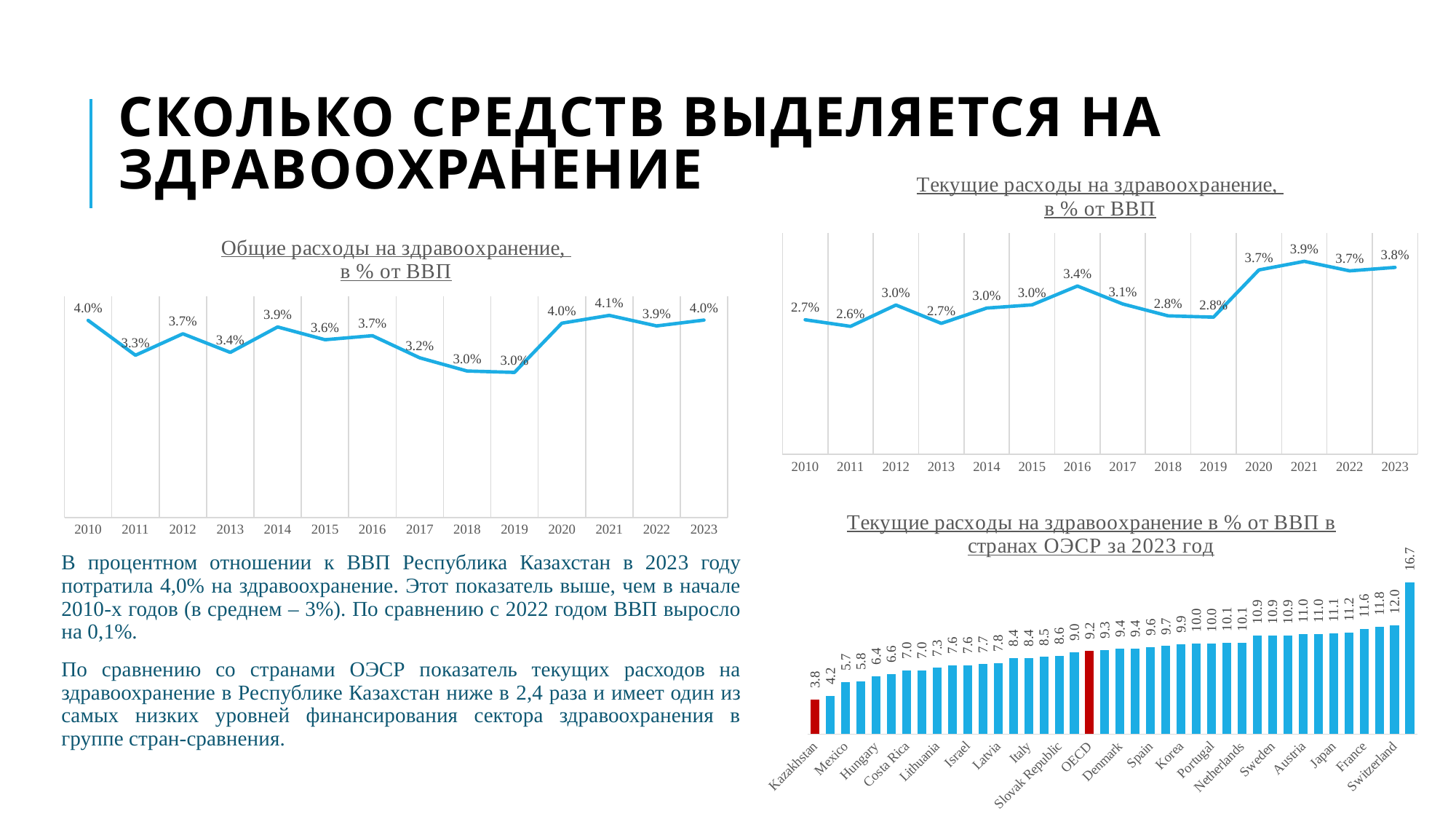
On the chart 'Текущие расходы на здравоохранение, в % от ВВП' (top right), what is the difference between the 2023 value and the 2010 value? 1.1% On the chart 'Общие расходы на здравоохранение, в % от ВВП', how many years are plotted? 14 On the bar chart of OECD countries for 2023, what is the value for Kazakhstan? 3.8 What kind of chart is 'Текущие расходы на здравоохранение в % от ВВП в странах ОЭСР за 2023 год'? bar chart On the chart 'Общие расходы на здравоохранение, в % от ВВП', what is the value for 2023? 4.0% On the chart 'Общие расходы на здравоохранение, в % от ВВП', what is the value for 2017? 3.2% On the chart 'Текущие расходы на здравоохранение, в % от ВВП' (top right), what is the value for 2021? 3.9% On the bar chart of OECD countries for 2023, what is the difference between the OECD value and the Kazakhstan value? 5.4 On the chart 'Общие расходы на здравоохранение, в % от ВВП', which year has the highest value? 2021 On the chart 'Текущие расходы на здравоохранение, в % от ВВП' (top right), which year has the lowest value? 2011 On the chart 'Текущие расходы на здравоохранение, в % от ВВП' (top right), is the value for 2016 larger or smaller than the value for 2017? larger